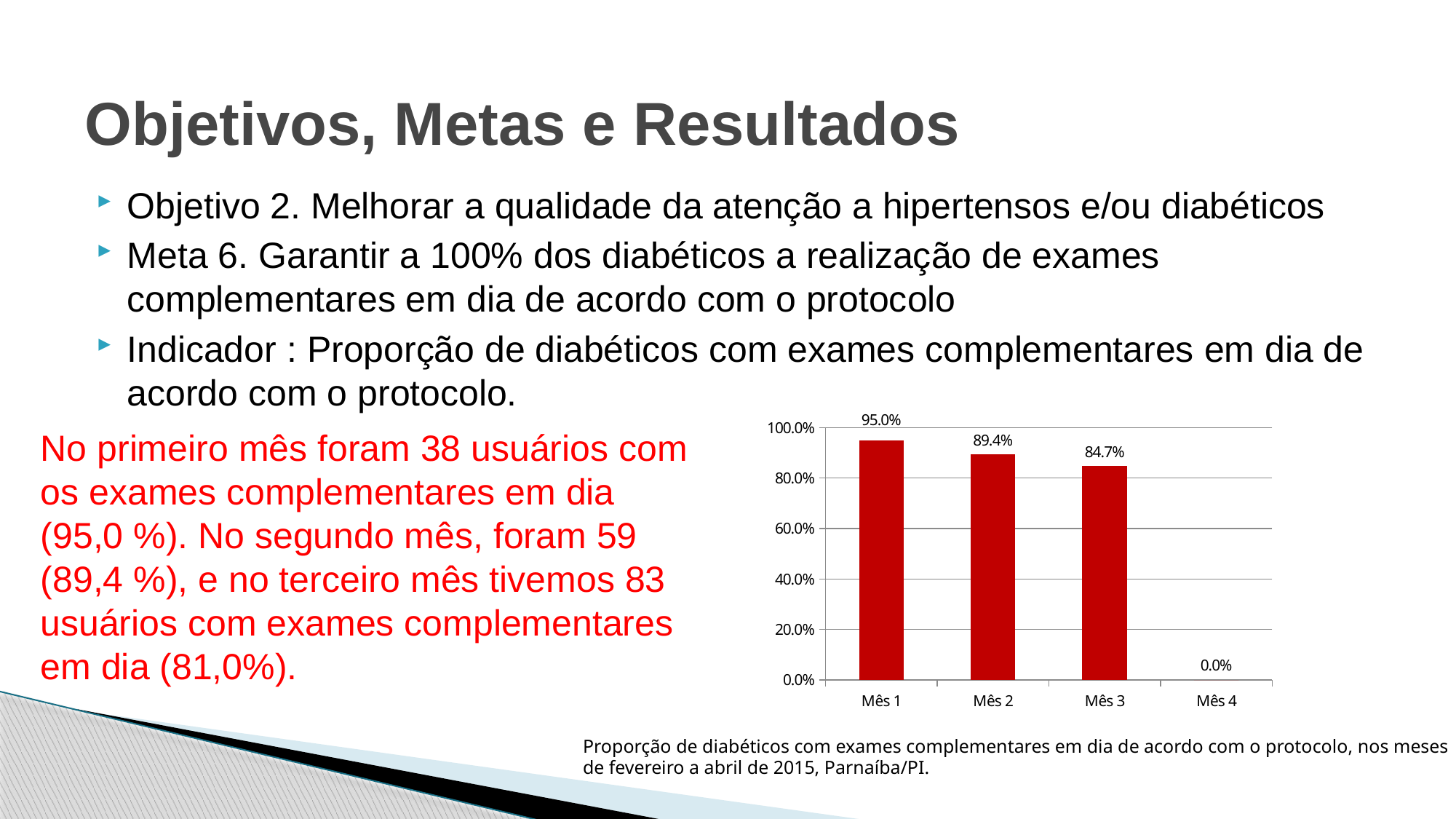
How many months are shown on the x axis? 4 What is the difference between the values for Mês 1 and Mês 3? 10.3% What is the value for Mês 4? 0.0% What kind of chart is shown? bar chart What is the value for Mês 3? 84.7% What is the value for Mês 1? 95.0% What is the value for Mês 2? 89.4% Do the values rise or fall from Mês 1 to Mês 3? fall Which month has the highest value? Mês 1 Is the value for Mês 2 greater or less than 80.0%? greater Which is larger, the value for Mês 2 or the value for Mês 3? Mês 2 Which month has the lowest value? Mês 4